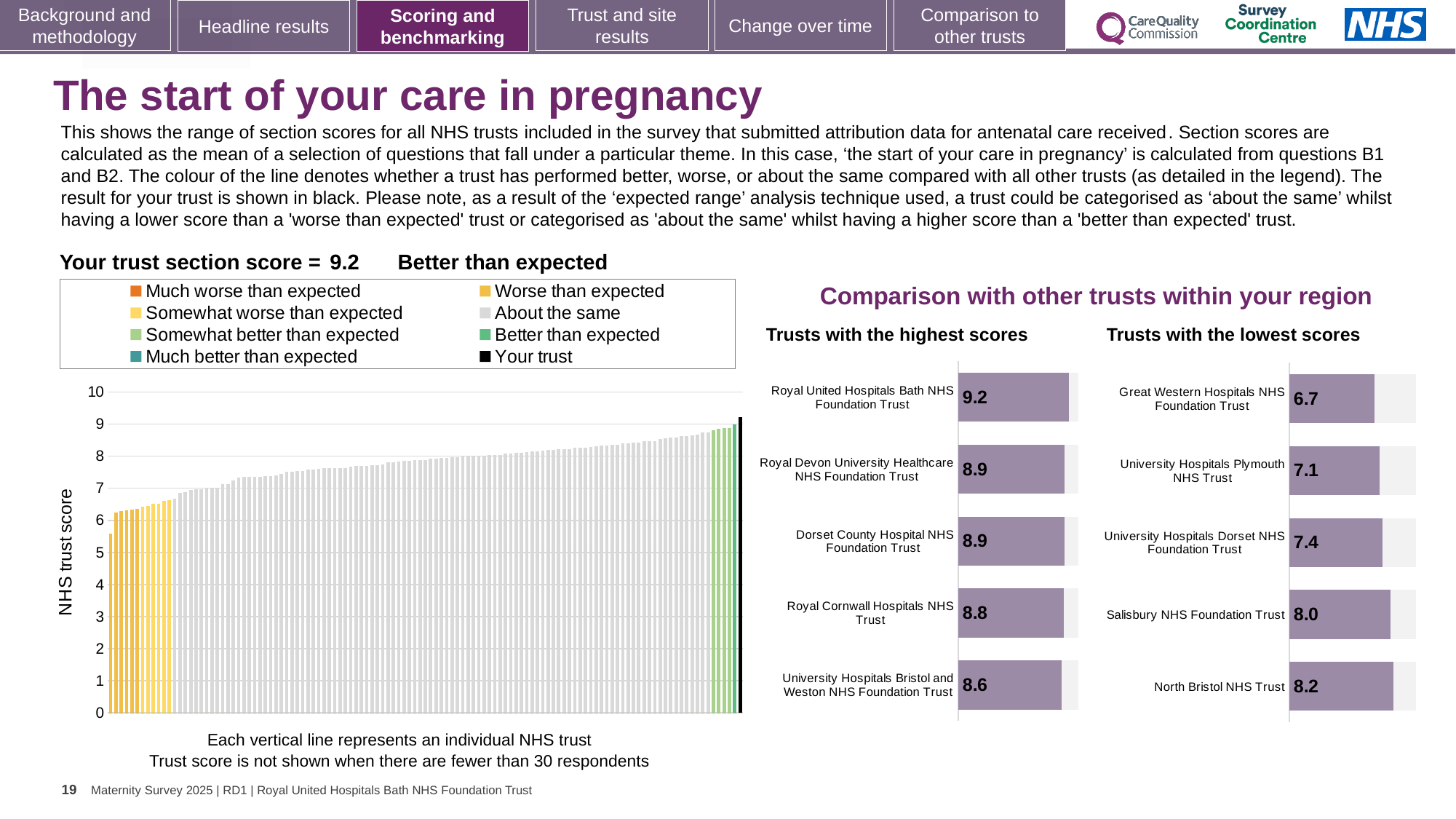
In the 'Trusts with the lowest scores' chart, what is the score for Salisbury NHS Foundation Trust? 8.0 How many trusts are shown in the 'Trusts with the highest scores' chart? 5 In the 'Trusts with the highest scores' chart, what is the score for Royal Cornwall Hospitals NHS Trust? 8.8 In the 'Trusts with the lowest scores' chart, which has the higher score: University Hospitals Plymouth NHS Trust or University Hospitals Dorset NHS Foundation Trust? University Hospitals Dorset NHS Foundation Trust In the 'Trusts with the highest scores' chart, which trust has the highest score? Royal United Hospitals Bath NHS Foundation Trust In the 'Trusts with the highest scores' chart, what is the difference between the scores of Royal United Hospitals Bath NHS Foundation Trust and University Hospitals Bristol and Weston NHS Foundation Trust? 0.6 In the large 'NHS trust score' chart on the left, do the bar values rise or fall from left to right? rise What kind of chart is the large 'NHS trust score' chart on the left of the slide? bar chart In the 'Trusts with the lowest scores' chart, what is the difference between the scores of North Bristol NHS Trust and Great Western Hospitals NHS Foundation Trust? 1.5 How many entries does the legend above the large 'NHS trust score' chart list? 8 In the 'Trusts with the lowest scores' chart, which trust has the lowest score? Great Western Hospitals NHS Foundation Trust In the large 'NHS trust score' chart on the left, is the value of the leftmost bar greater or less than 7? less